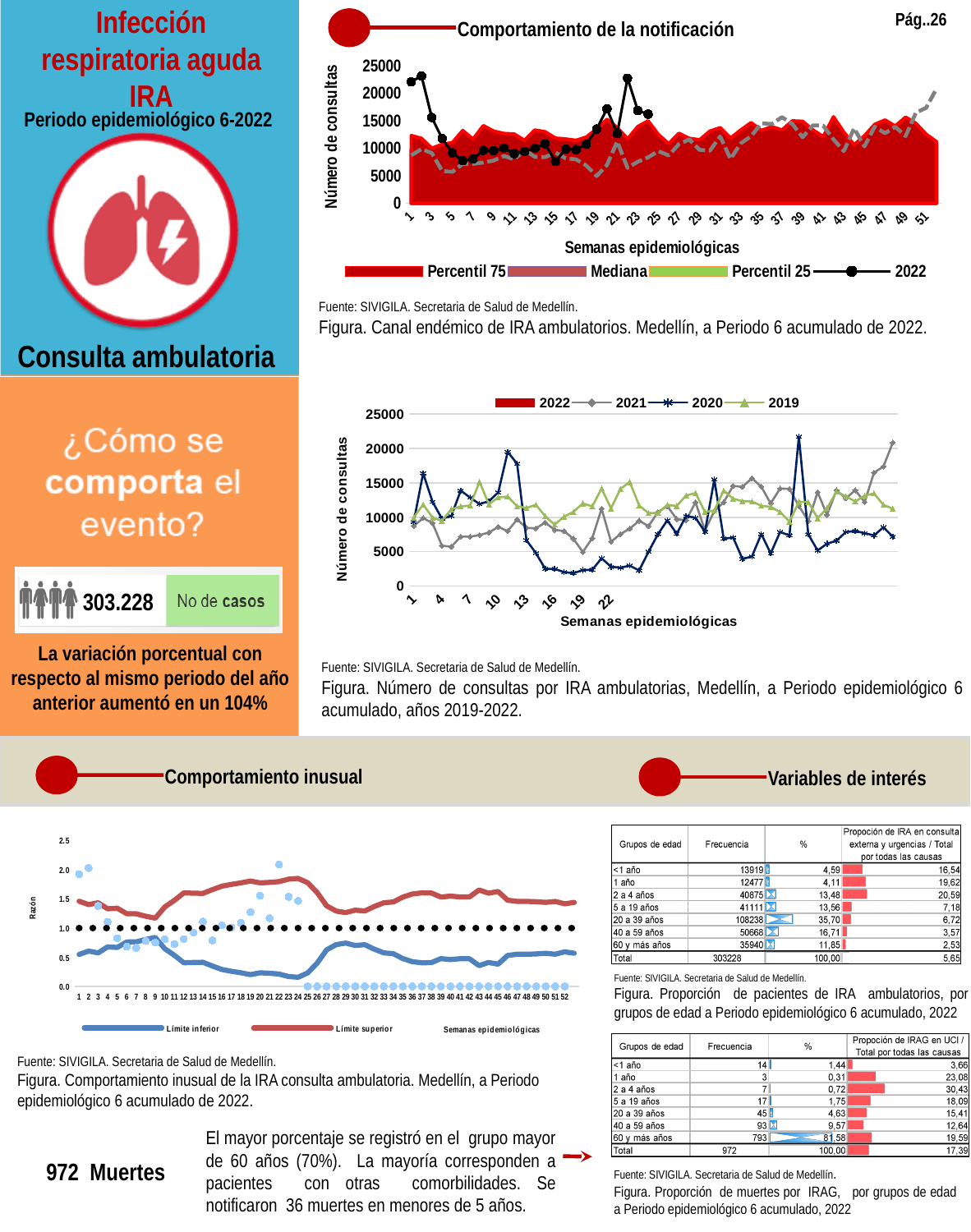
In the top chart 'Comportamiento de la notificación', is the 2022 value at week 1 greater or less than 20000? greater In the middle chart of consultas por IRA ambulatorias (2019-2022), is the 2020 value at week 16 greater or less than 5000? less In the bottom-left chart 'Comportamiento inusual', what kind of chart is it? line chart In the top chart 'Comportamiento de la notificación', how many series does the legend list? 4 In the middle chart of consultas por IRA ambulatorias (2019-2022), is the 2020 value at week 10 greater or less than 15000? less In the middle chart of consultas por IRA ambulatorias (2019-2022), what is the highest value shown on the y axis? 25000 In the bottom-right table of muertes por IRAG by age group, which age group has the highest percentage? 60 y más años In the bottom-left chart 'Comportamiento inusual', how many series does the legend list? 2 In the middle chart of consultas por IRA ambulatorias (2019-2022), how many series does the legend list? 4 In the bottom-right table of IRA ambulatorios by age group, what is the Frecuencia for '20 a 39 años'? 108238 In the top chart 'Comportamiento de la notificación', what is the label of the y axis? Número de consultas